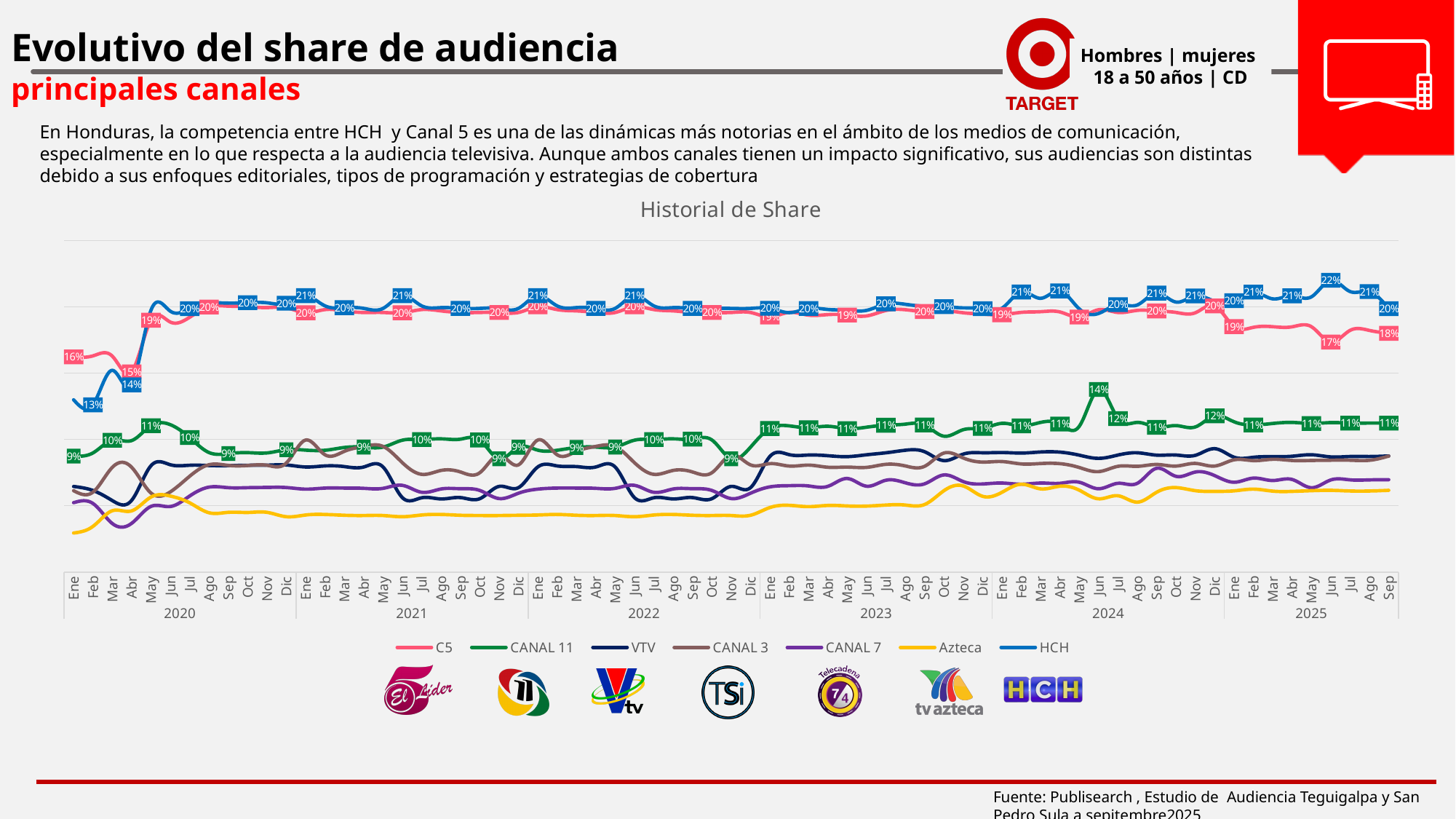
Does the HCH line rise or fall from Ene 2020 to Sep 2025? rise What is the share value for HCH in Ene 2020? 13% What is the share value for CANAL 11 in Sep 2025? 11% In Sep 2025, how many percentage points higher is HCH than C5? 2 What is the share value for C5 in Ene 2020? 16% What is the highest labelled share value reached by CANAL 11? 14% How many series does the legend of the 'Historial de Share' chart list? 7 What is the share value for HCH in Sep 2025? 20% What is the highest labelled share value reached by HCH? 22% In Ene 2020, which had the larger share, C5 or HCH? C5 What kind of chart is shown under the title 'Historial de Share'? line chart What is the share value for C5 in Sep 2025? 18%